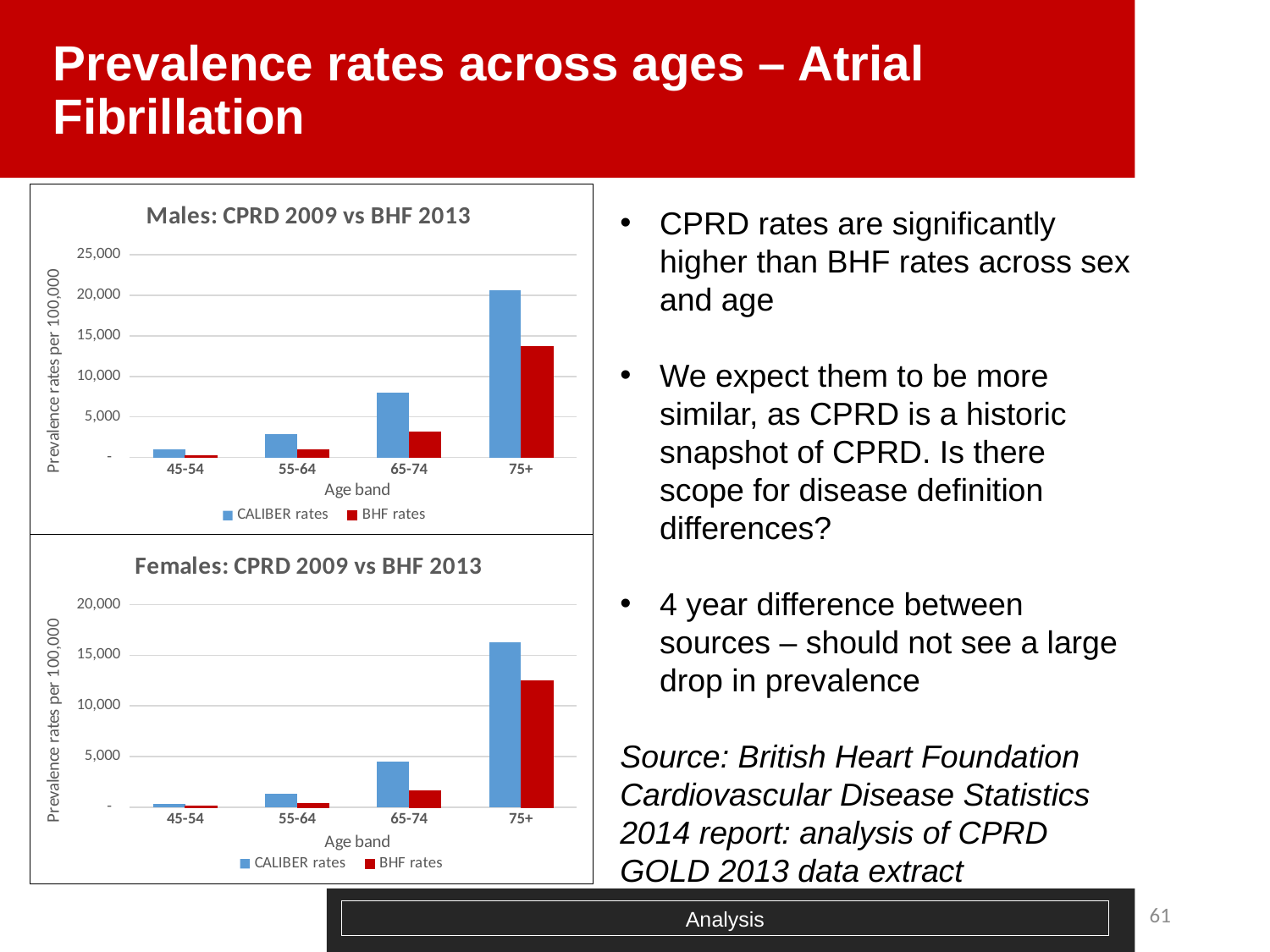
What type of chart is the 'Males: CPRD 2009 vs BHF 2013' chart? bar chart How many age bands are shown on the x axis of the 'Females: CPRD 2009 vs BHF 2013' chart? 4 What is the y-axis label of the 'Males: CPRD 2009 vs BHF 2013' chart? Prevalence rates per 100,000 In the 'Males: CPRD 2009 vs BHF 2013' chart, which age band has the highest CALIBER rate? 75+ In the 'Males: CPRD 2009 vs BHF 2013' chart, is the BHF rate for 65-74 greater or less than 5,000? less In the 'Females: CPRD 2009 vs BHF 2013' chart, do the CALIBER rates rise or fall as the age band increases? rise In the 'Males: CPRD 2009 vs BHF 2013' chart, which is larger for the 65-74 age band, the CALIBER rate or the BHF rate? CALIBER rate In the 'Females: CPRD 2009 vs BHF 2013' chart, is the CALIBER rate for 65-74 greater or less than 5,000? less In the 'Females: CPRD 2009 vs BHF 2013' chart, which age band has the lowest BHF rate? 45-54 In the 'Females: CPRD 2009 vs BHF 2013' chart, is the BHF rate for 75+ greater or less than 10,000? greater How many series does the legend of the 'Males: CPRD 2009 vs BHF 2013' chart list? 2